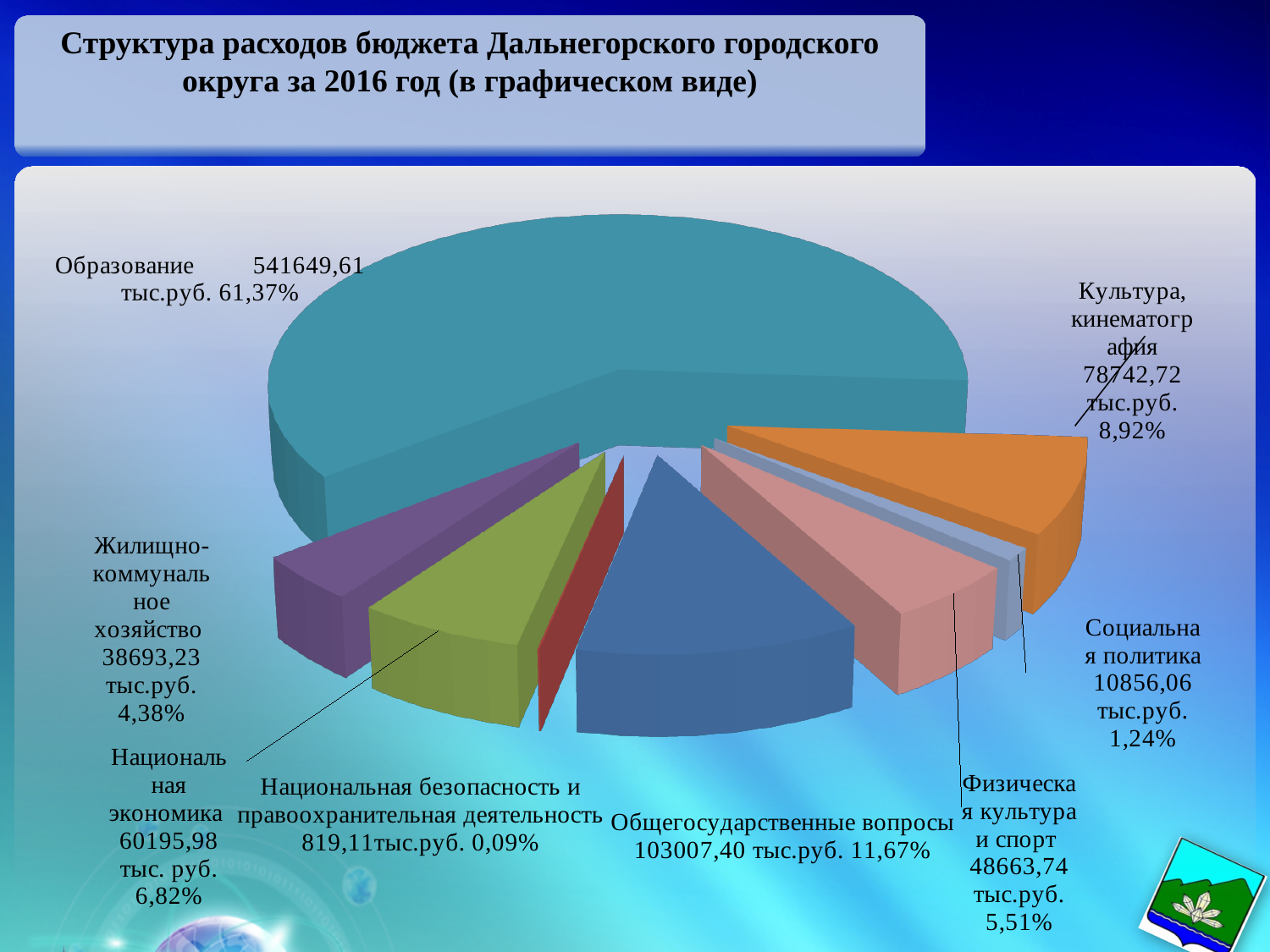
How many categories (slices) does the pie chart show? 8 What is the title of the chart on the slide? Структура расходов бюджета Дальнегорского городского округа за 2016 год (в графическом виде) What percentage is shown for Физическая культура и спорт? 5,51% What is the value for Общегосударственные вопросы in тыс.руб.? 103007,40 What is the difference in percentage points between Общегосударственные вопросы (11,67%) and Культура, кинематография (8,92%)? 2,75% What is the value for Образование in тыс.руб.? 541649,61 What kind of chart is shown on the slide? pie chart Which category has the smallest share of the pie? Национальная безопасность и правоохранительная деятельность Which category has the largest share of the pie? Образование What is the value for Социальная политика in тыс.руб.? 10856,06 Which is larger: Культура, кинематография or Национальная экономика? Культура, кинематография What share of the pie does Образование take? 61,37%